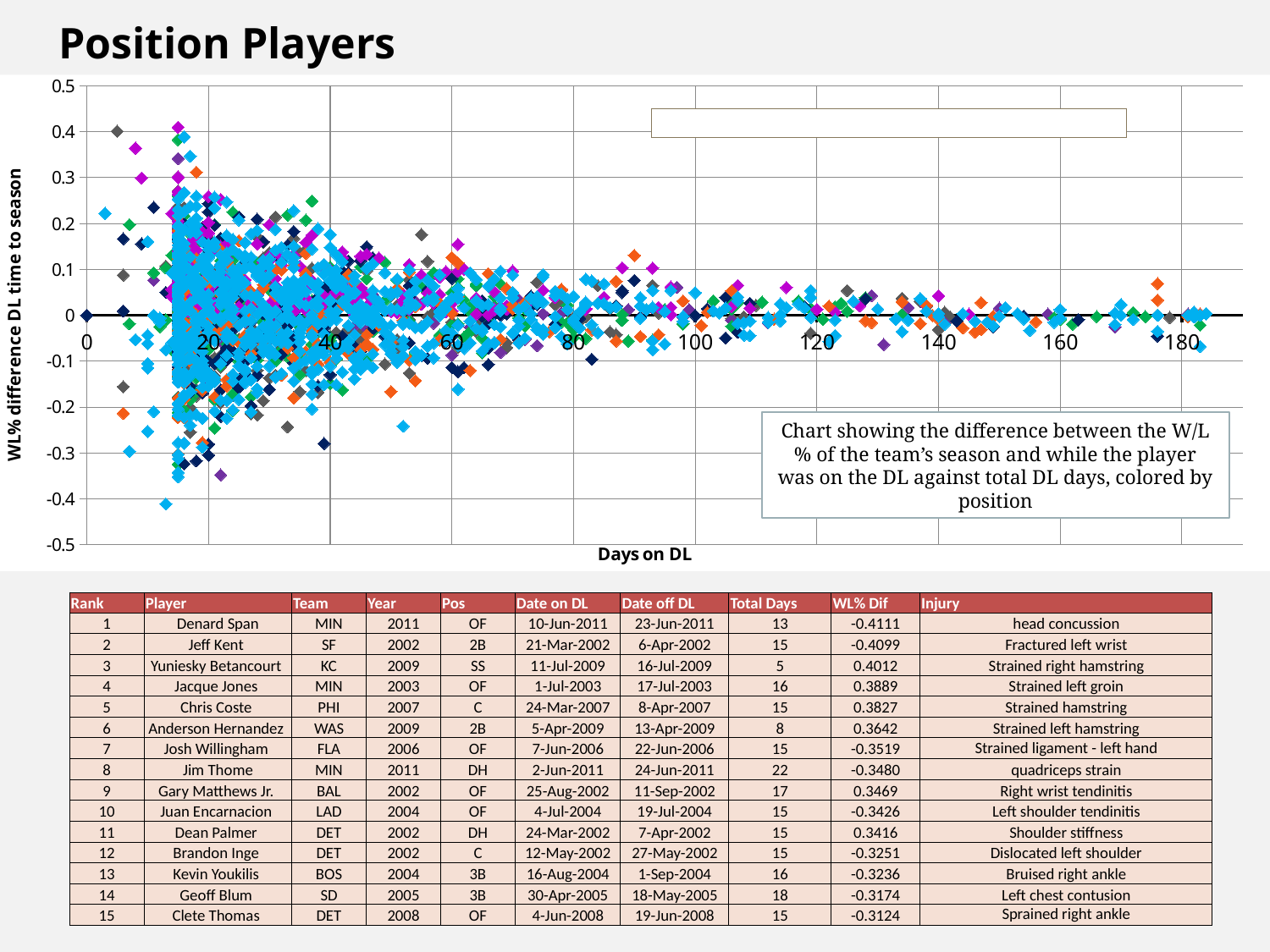
As Days on DL increases along the x axis, does the spread of the plotted points get wider or narrower? narrower What is the title of the vertical axis of the chart? WL% difference DL time to season What kind of chart is shown on the slide? scatter chart What is the title of the horizontal axis of the chart? Days on DL